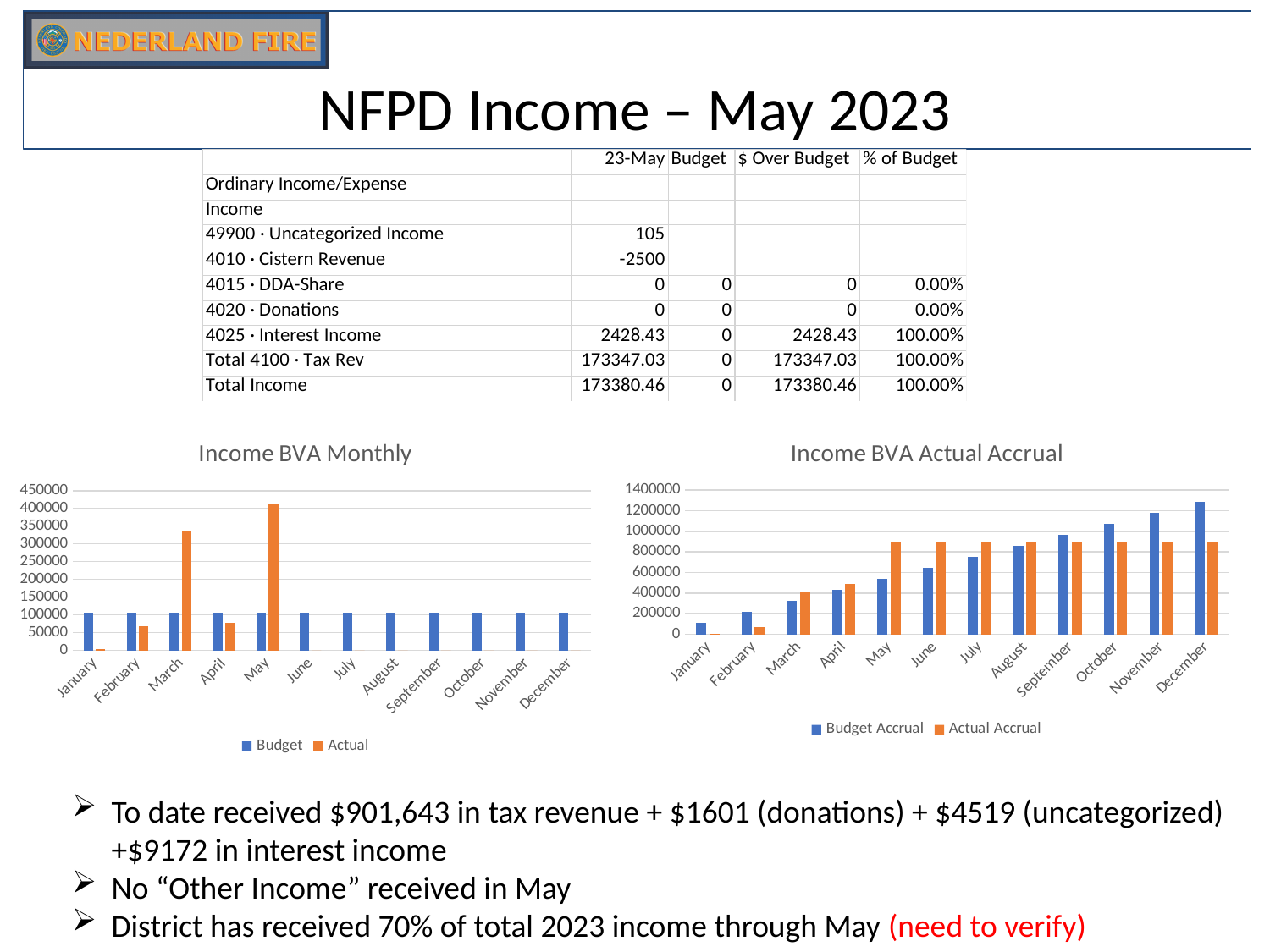
In the "Income BVA Actual Accrual" chart, is the Actual Accrual value for May greater or less than 800000? greater What kind of chart is the "Income BVA Monthly" chart? bar chart What kind of chart is the "Income BVA Actual Accrual" chart? bar chart In the "Income BVA Monthly" chart, is the Actual value for March greater or less than 300000? greater How many series does the legend of the "Income BVA Monthly" chart list? 2 In the "Income BVA Monthly" chart, which month has the highest Actual value? May In the "Income BVA Actual Accrual" chart, does the Budget Accrual series rise or fall from January to December? rise How many months are shown on the x axis of the "Income BVA Monthly" chart? 12 In the "Income BVA Monthly" chart, is the Actual value for February greater or less than 100000? less In the "Income BVA Monthly" chart, which is larger: the Actual value for March or the Actual value for April? March In the "Income BVA Actual Accrual" chart, which is larger for December: Budget Accrual or Actual Accrual? Budget Accrual What are the two legend entries of the "Income BVA Actual Accrual" chart? Budget Accrual and Actual Accrual